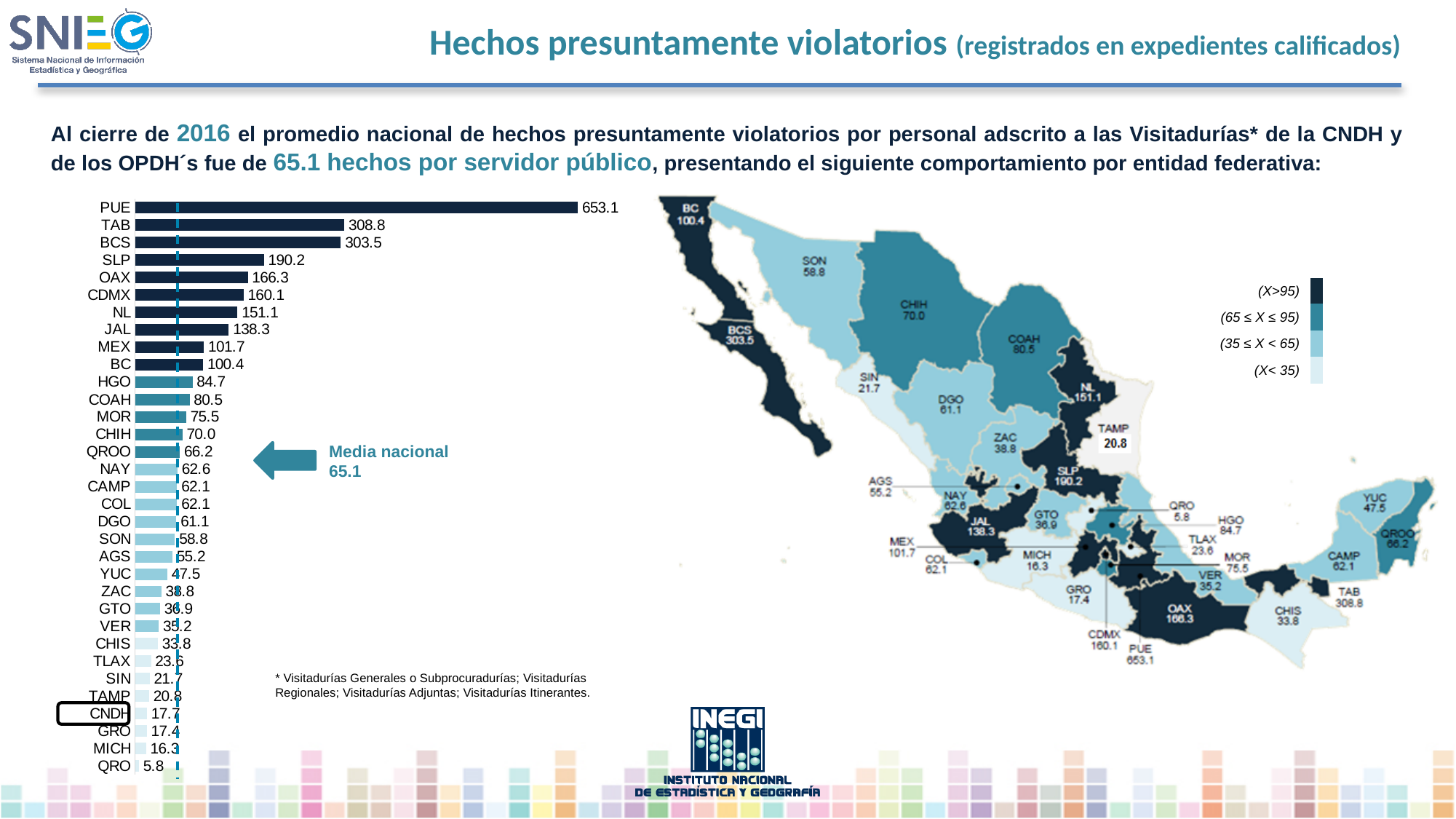
What is the difference between the values for TAB and BCS in the bar chart? 5.3 What kind of chart is shown on the left of the slide? Bar chart What is the value for PUE in the bar chart? 653.1 Which has a larger value in the bar chart, HGO or COAH? HGO What is the difference between the values for SLP and OAX in the bar chart? 23.9 Which category has the highest value in the bar chart? PUE Which has a larger value in the bar chart, NL or JAL? NL How many categories are shown in the bar chart? 33 What is the value of the national mean (Media nacional) marked by the dashed line in the bar chart? 65.1 What is the value for CDMX in the bar chart? 160.1 Which category has the lowest value in the bar chart? QRO What is the value for CNDH in the bar chart? 17.7